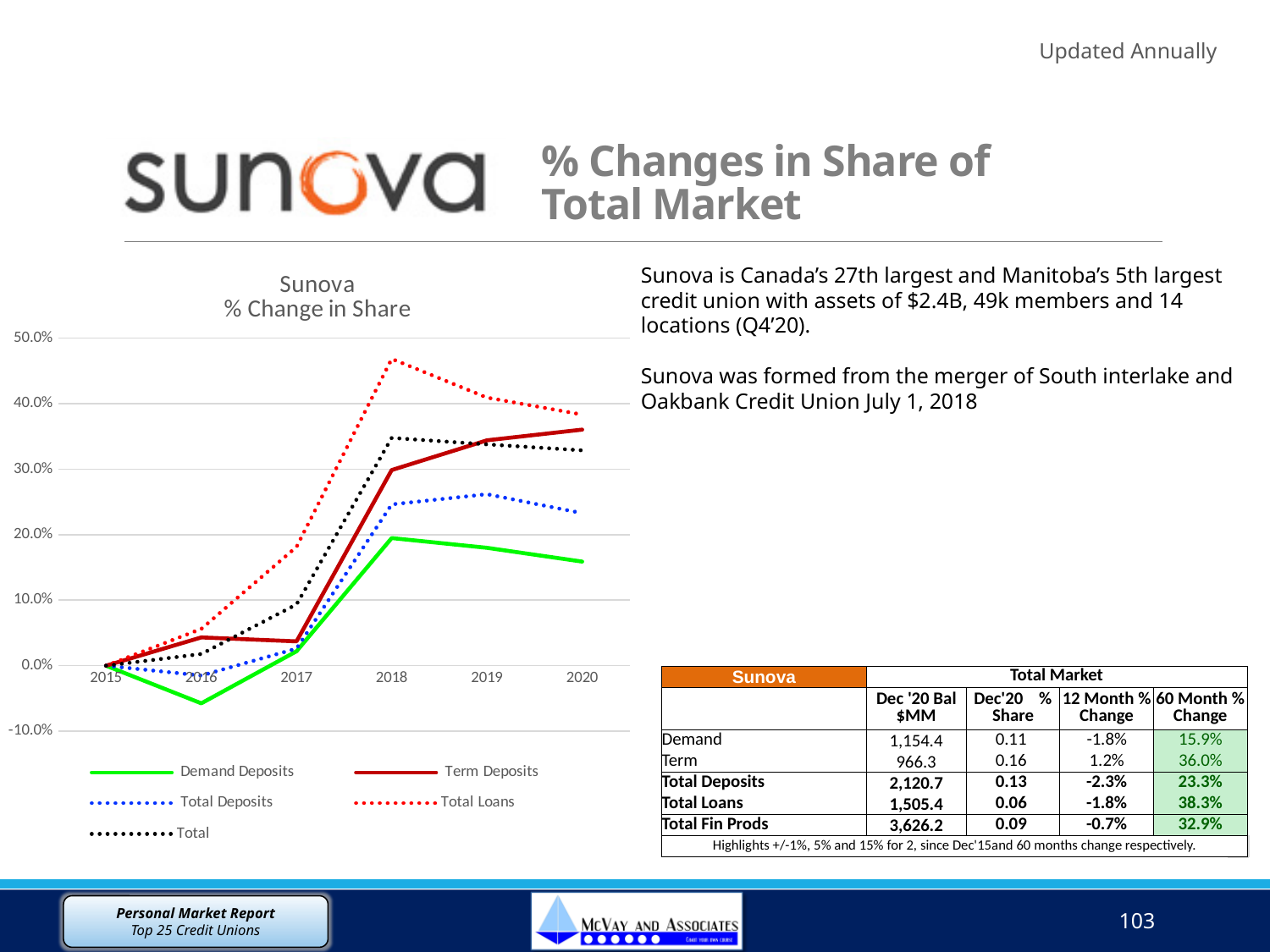
Does the Demand Deposits line rise or fall from 2018 to 2020? Fall Is the value for Total Loans in 2018 greater or less than 40.0%? greater Which series is lowest in 2020? Demand Deposits Is the value for Term Deposits in 2020 greater or less than 30.0%? greater What is the title of the chart? Sunova % Change in Share In 2019, which is larger: Term Deposits or Total Deposits? Term Deposits How many years are shown along the x axis of the chart? 6 Is the value for Demand Deposits in 2016 greater or less than 0.0%? less How many series does the chart legend list? 5 Which series is highest in 2018? Total Loans What kind of chart is shown on the slide? Line chart What colour is the Demand Deposits line? Green